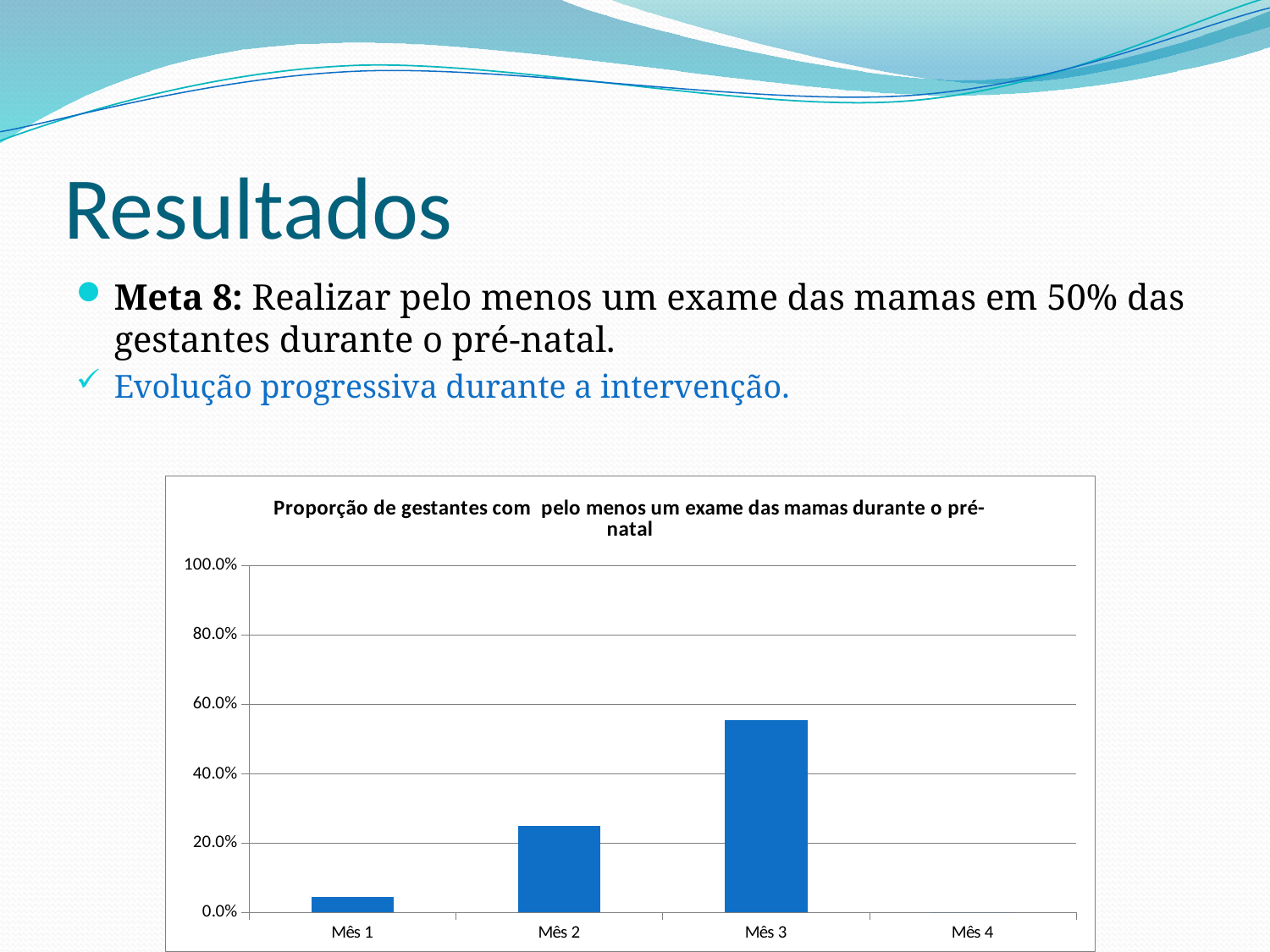
Is the value for Mês 3 greater or less than 60.0%? less What is the highest value shown on the y axis of the chart? 100.0% Is the value for Mês 2 greater or less than 20.0%? greater Is the value for Mês 3 greater or less than 40.0%? greater What is the title of the chart? Proporção de gestantes com pelo menos um exame das mamas durante o pré-natal What kind of chart is shown on the slide? bar chart Which of Mês 2 and Mês 3 has the larger value? Mês 3 How many categories are labelled on the x axis of the chart? 4 Which month has the tallest bar in the chart? Mês 3 Do the values rise or fall from Mês 1 to Mês 3? rise Which of Mês 1 and Mês 2 has the smaller value? Mês 1